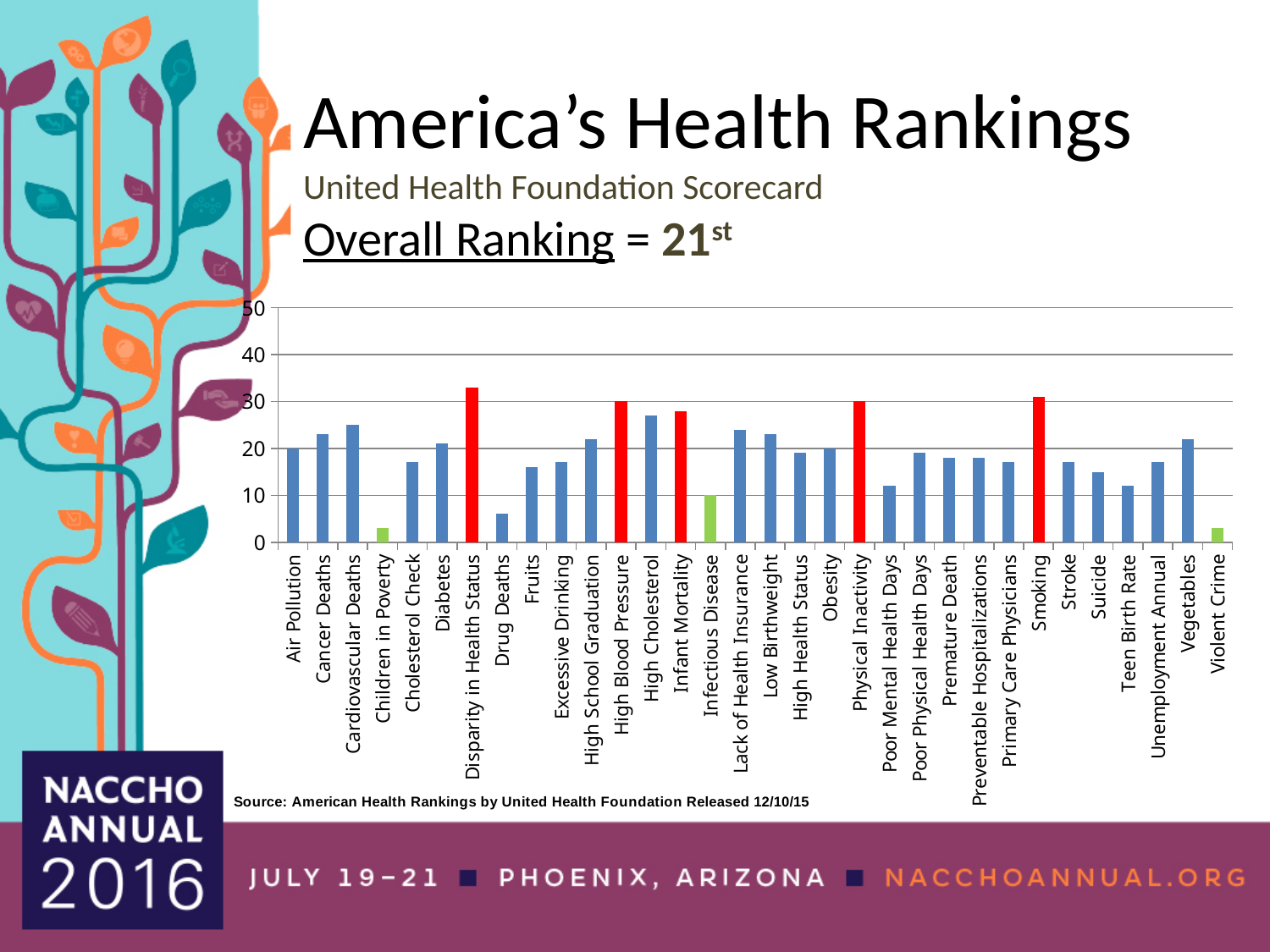
How many categories are plotted along the x axis of the chart? 32 What overall ranking is stated above the chart? 21st Is the value for Cardiovascular Deaths greater or less than 20? greater What kind of chart is shown on the slide? bar chart Which is larger, the value for Teen Birth Rate or the value for Vegetables? Vegetables How many bars in the chart are coloured red? 5 What is the value for Infectious Disease? 10 Which is larger, the value for Smoking or the value for Suicide? Smoking Is the value for Drug Deaths greater or less than 10? less Is the value for Disparity in Health Status greater or less than 30? greater